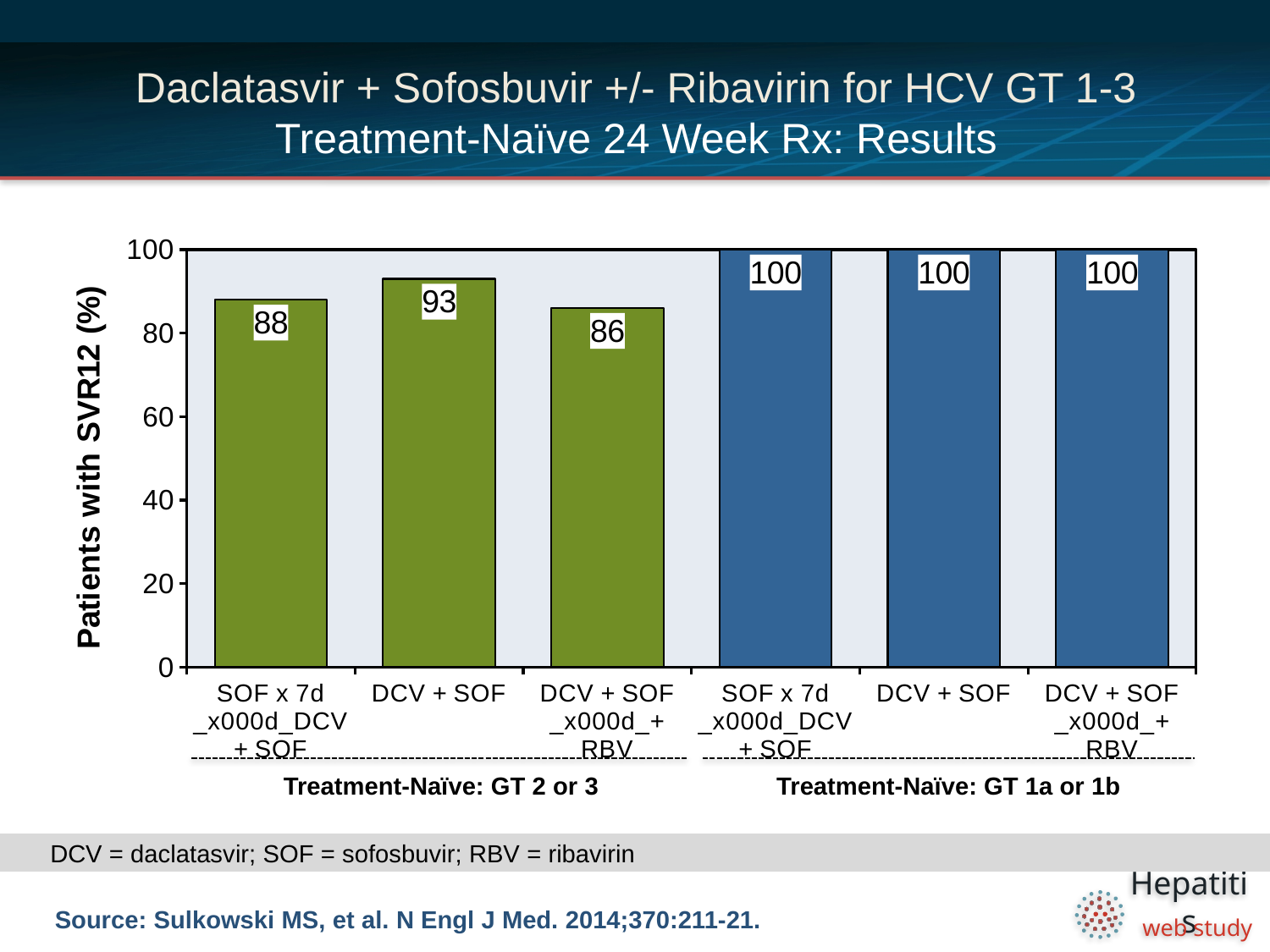
Which has a higher SVR12 rate: DCV + SOF in the GT 2 or 3 group or DCV + SOF in the GT 1a or 1b group? DCV + SOF in the GT 1a or 1b group What is the SVR12 rate for DCV + SOF in the Treatment-Naïve: GT 2 or 3 group? 93 Which regimen in the Treatment-Naïve: GT 2 or 3 group has the lowest SVR12 rate? DCV + SOF + RBV What type of chart is shown on the slide? Bar chart What is the label of the y-axis? Patients with SVR12 (%) What is the SVR12 rate for DCV + SOF + RBV in the Treatment-Naïve: GT 1a or 1b group? 100 How many bars are plotted in the chart? 6 What colour are the bars for the Treatment-Naïve: GT 1a or 1b group? Blue Which regimen in the Treatment-Naïve: GT 2 or 3 group has the highest SVR12 rate? DCV + SOF What is the SVR12 rate for DCV + SOF + RBV in the Treatment-Naïve: GT 2 or 3 group? 86 What is the difference in SVR12 rate between DCV + SOF and DCV + SOF + RBV in the Treatment-Naïve: GT 2 or 3 group? 7 What is the SVR12 rate for SOF x 7d then DCV + SOF in the Treatment-Naïve: GT 2 or 3 group? 88